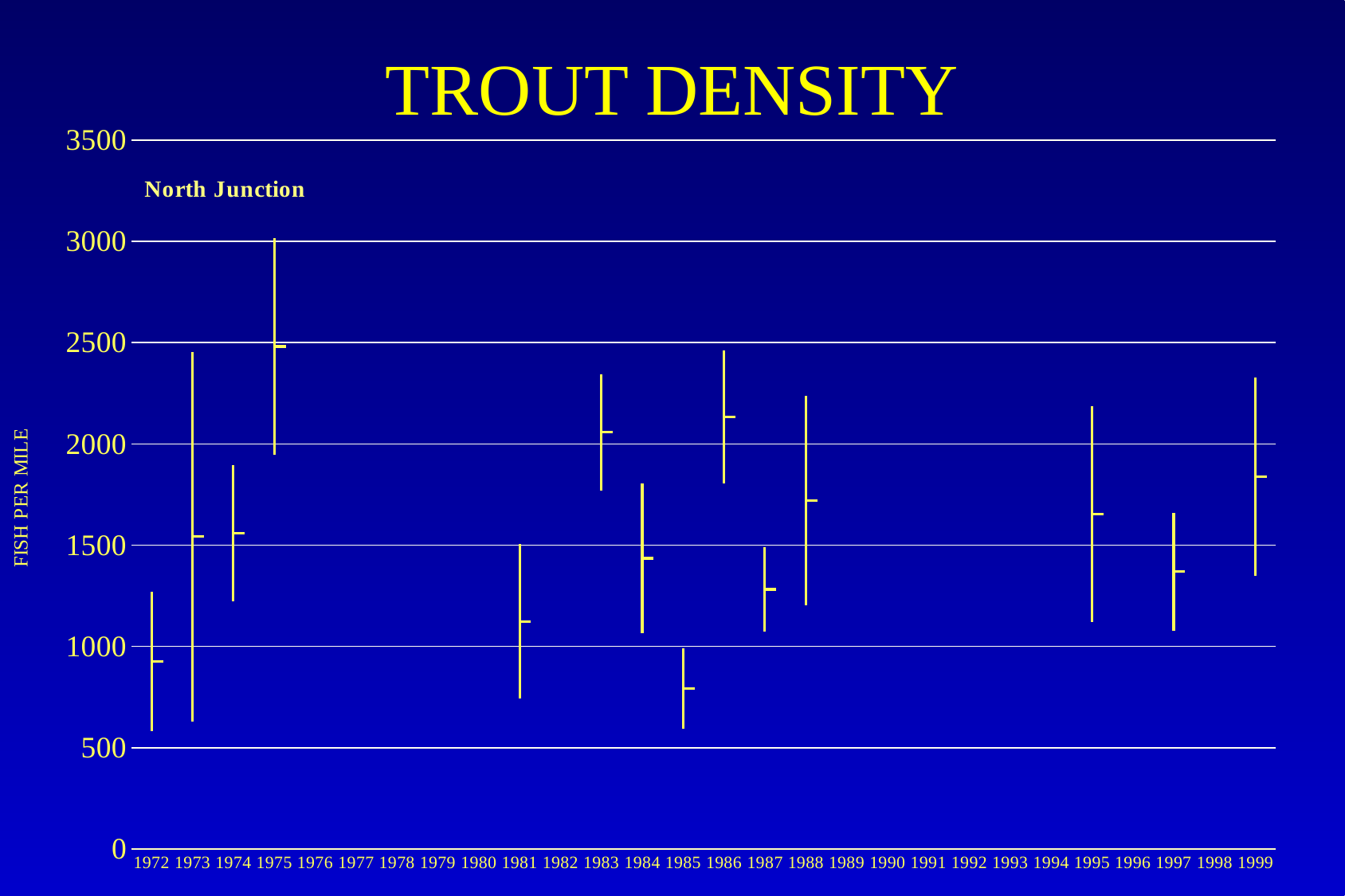
Is the central value for 1986 greater or less than 2000? greater Which year has the larger central value, 1981 or 1995? 1995 Is the central value for 1999 greater or less than 1500? greater Which year has the lowest central (tick) value? 1985 What is the title of the chart? TROUT DENSITY Which year has the highest central (tick) value? 1975 What is the label on the vertical axis? FISH PER MILE Which year has the larger central value, 1986 or 1984? 1986 Is the central value for 1987 greater or less than 1500? less How many years are labelled along the x axis? 28